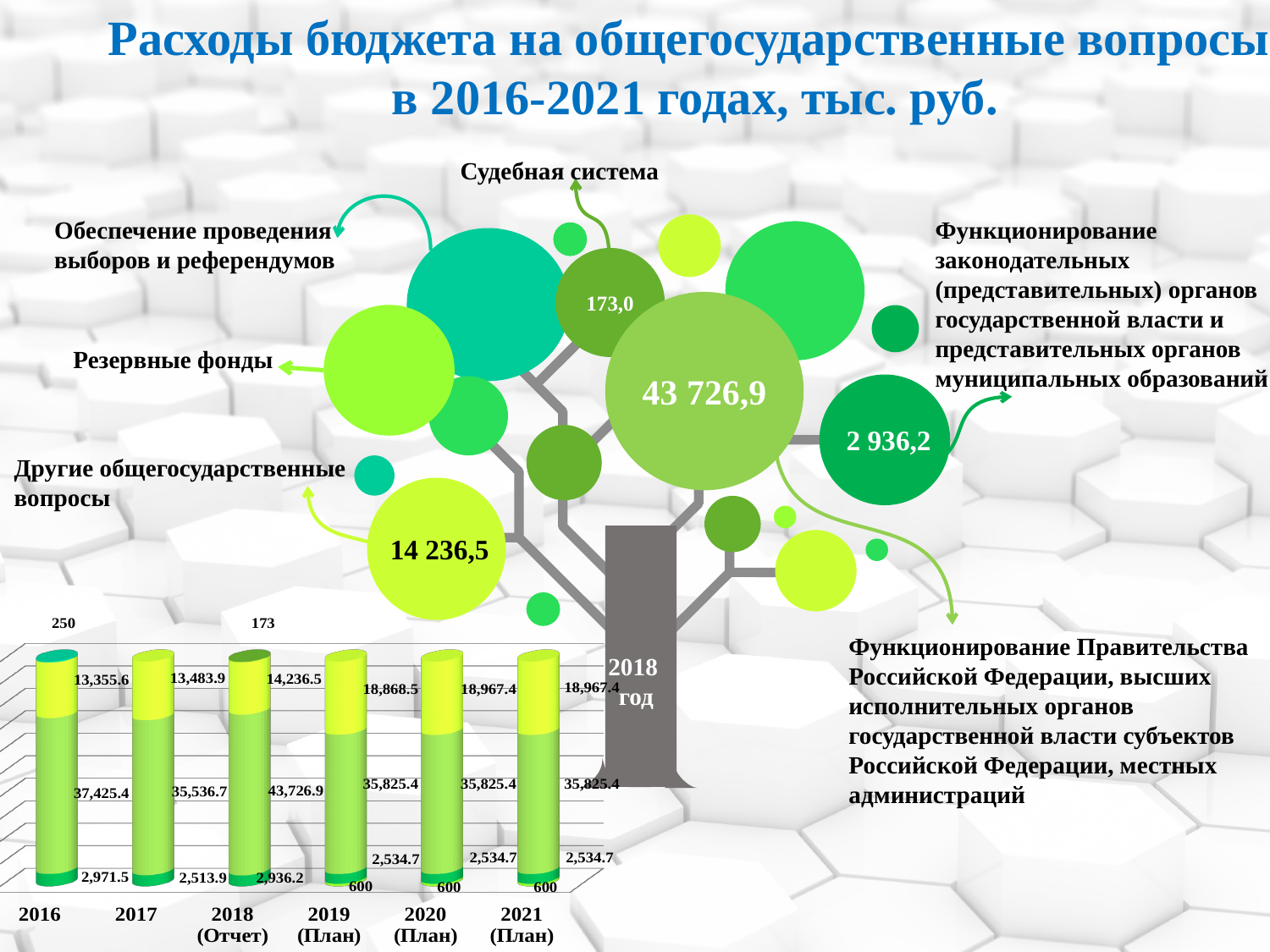
In the bar chart, which year has the smallest top (yellow-green) segment? 2016 In the bar chart, which year has the largest middle (green) segment? 2018 (Отчет) In the tree diagram, what value is shown for Функционирование законодательных (представительных) органов? 2 936,2 What kind of chart is shown at the bottom left of the slide? Stacked bar chart In the bar chart, what is the difference between the middle segment values for 2018 and 2017? 8,190.2 In the bar chart, what is the difference between the bottom segment values for 2016 and 2017? 457.6 In the bar chart, what small value is labelled above the 2018 bar? 173 In the bar chart, is the top segment larger for 2019 (План) or for 2018 (Отчет)? 2019 (План) In the bar chart, what is the value of the bottom (dark green) segment for 2016? 2,971.5 How many years (categories) are shown on the x axis of the bar chart? 6 In the bar chart, what is the value of the top (yellow-green) segment for 2019 (План)? 18,868.5 In the bar chart, what is the value of the middle (green) segment for 2018 (Отчет)? 43,726.9